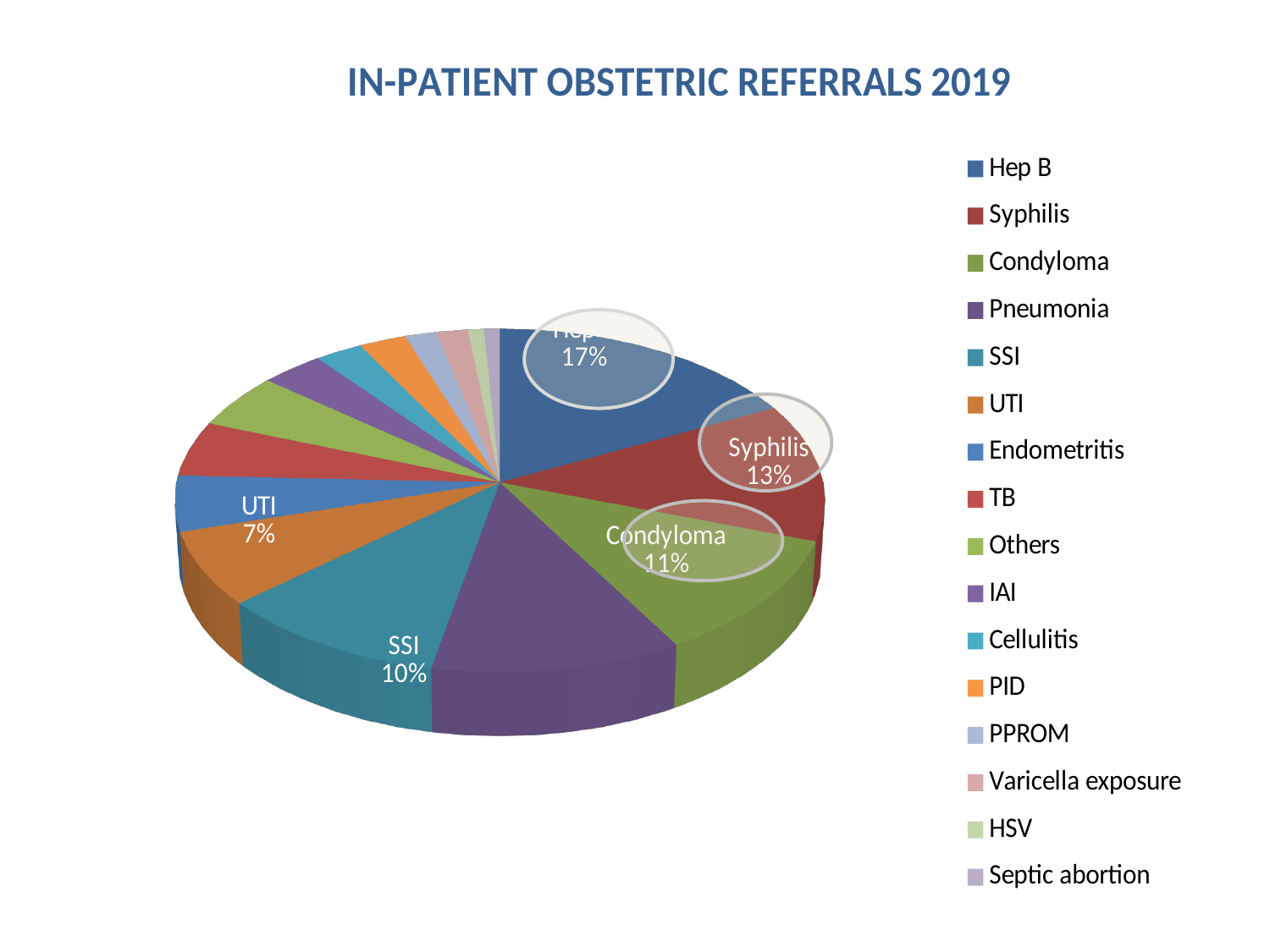
What percentage of the pie is labelled for Syphilis? 13% Which has the larger share, SSI or UTI? SSI How many categories are listed in the legend? 16 What is the difference between the Hep B share and the UTI share? 10% How many percentage points larger is the Hep B slice than the Syphilis slice? 4% Which is larger, the Syphilis slice or the Condyloma slice? Syphilis What is the title of the chart? IN-PATIENT OBSTETRIC REFERRALS 2019 What share of referrals is UTI? 7% What is the value shown for Condyloma? 11% What kind of chart is shown on the slide? Pie chart What percentage is shown for SSI? 10% What share of in-patient obstetric referrals in 2019 is Hep B? 17%